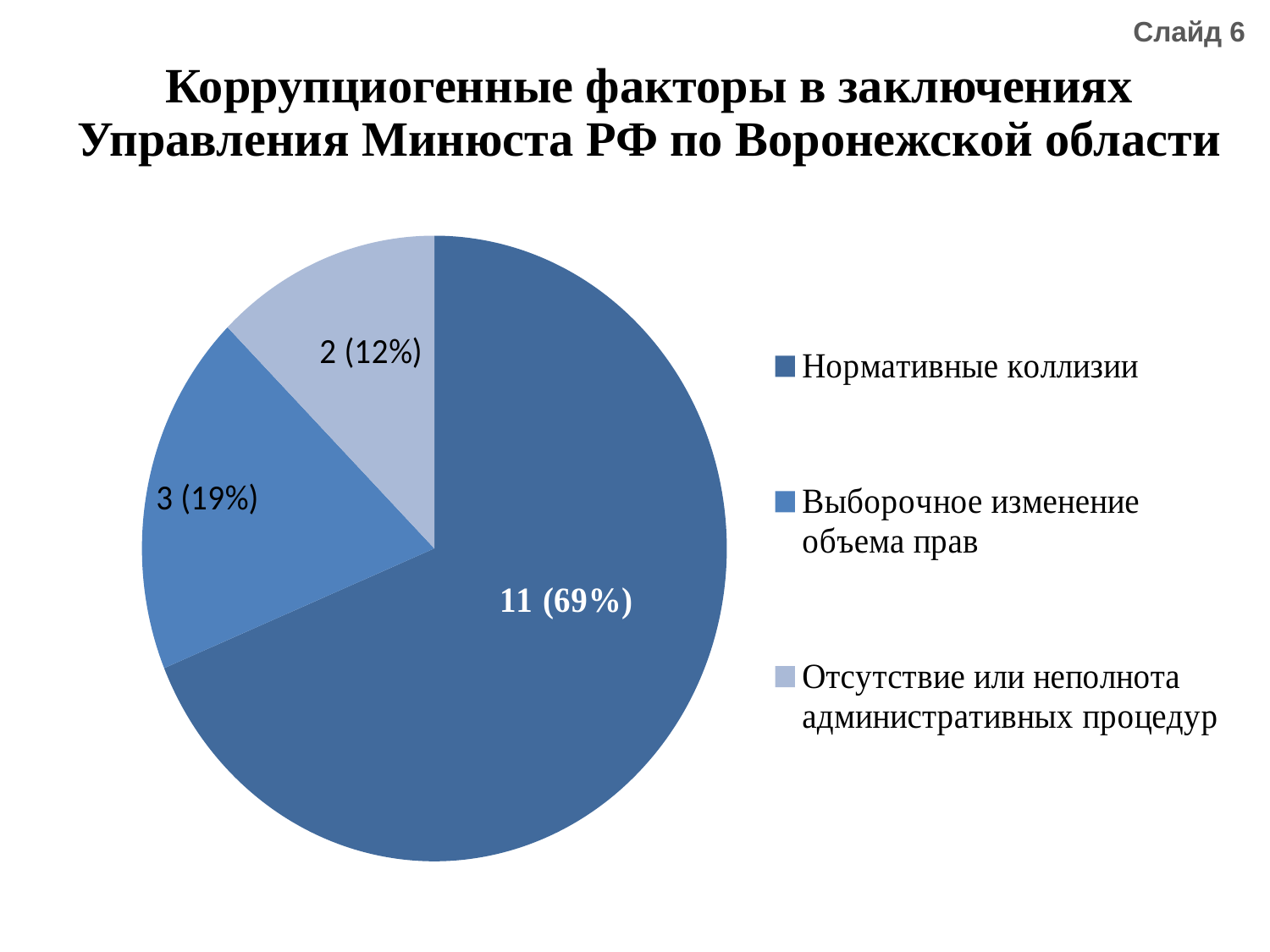
What share of the pie does "Выборочное изменение объема прав" take? 19% What is the difference in count between "Нормативные коллизии" and "Выборочное изменение объема прав"? 8 Which category has the smallest slice of the pie? Отсутствие или неполнота административных процедур What value is shown for the slice "Выборочное изменение объема прав"? 3 (19%) Which is larger: the count for "Выборочное изменение объема прав" or for "Отсутствие или неполнота административных процедур"? Выборочное изменение объема прав How many slices does the pie chart have? 3 What value is shown for the slice "Отсутствие или неполнота административных процедур"? 2 (12%) What kind of chart is shown on the slide? Pie chart Which category has the largest slice of the pie? Нормативные коллизии What share of the pie does "Нормативные коллизии" take? 69% What value is shown for the slice "Нормативные коллизии"? 11 (69%) What is the title of the chart on the slide? Коррупциогенные факторы в заключениях Управления Минюста РФ по Воронежской области